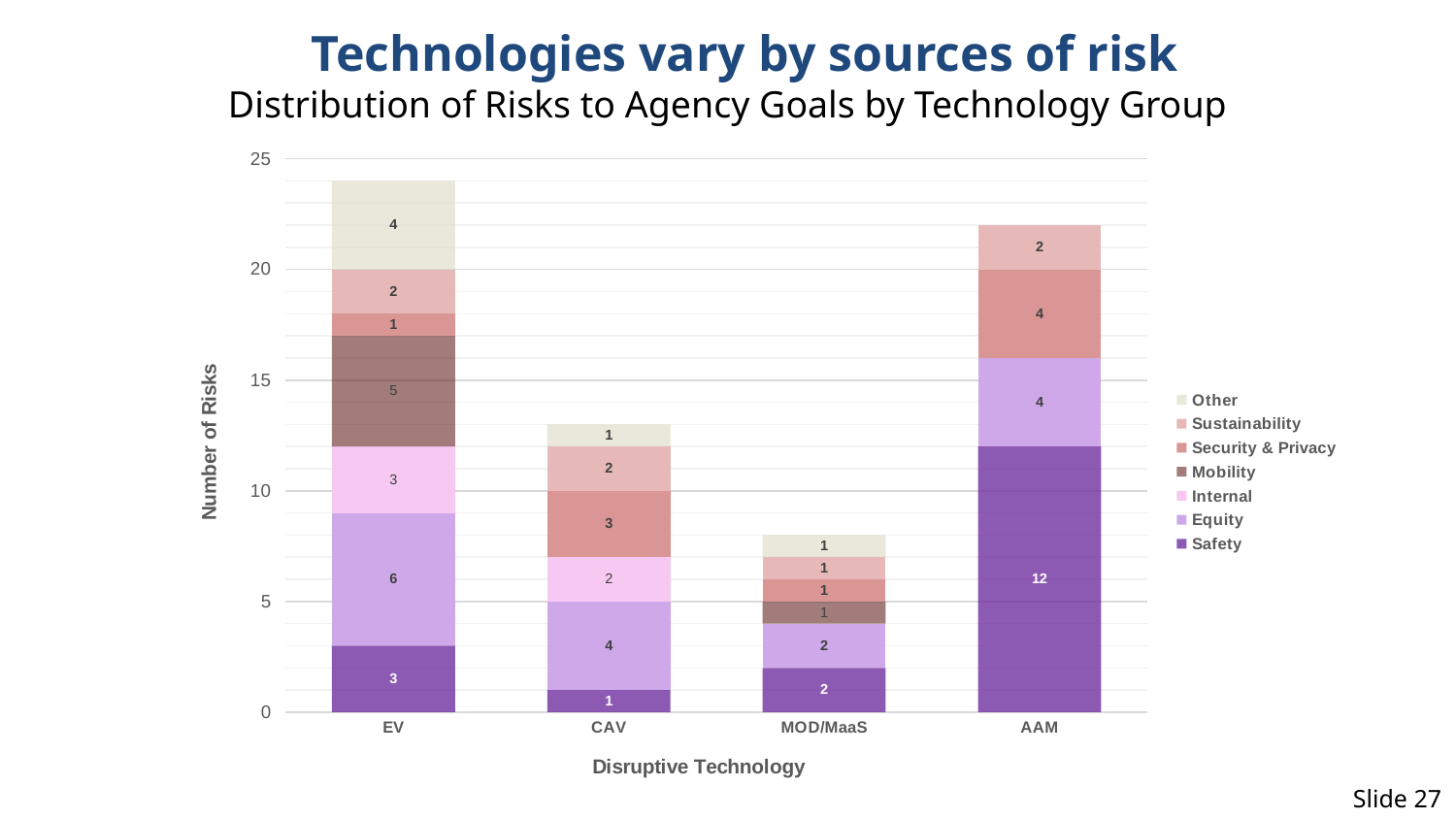
Which is larger, the Security & Privacy value for CAV or the Security & Privacy value for EV? CAV What is the total number of risks for the EV bar? 24 What is the difference between the Safety value for AAM and the Safety value for EV? 9 What is the Equity value for CAV? 4 How many technology groups are shown on the x axis? 4 What is the Mobility value for EV? 5 How many series does the legend list? 7 What is the Safety value for AAM? 12 Which technology group has the lowest total number of risks? MOD/MaaS What kind of chart is shown on the slide? Stacked bar chart What is the total number of risks for the AAM bar? 22 Which technology group has the highest total number of risks? EV